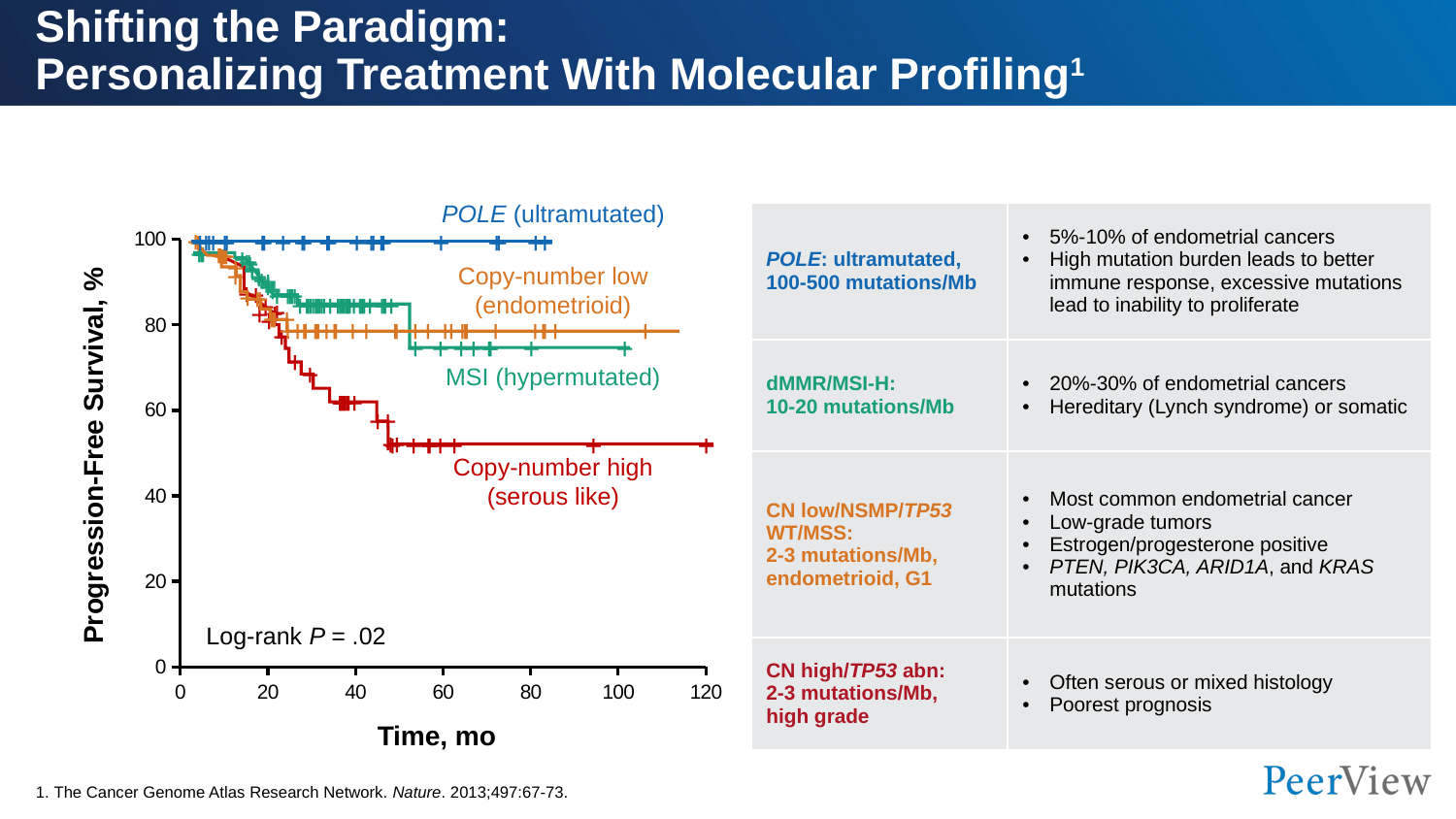
Is the progression-free survival for the Copy-number high (serous like) group at 100 months greater or less than 60%? less Does the Copy-number high (serous like) curve rise or fall as time increases? fall What is the label of the x axis of the chart? Time, mo Is the progression-free survival for the MSI (hypermutated) group at 100 months greater or less than 60%? greater Which group has the lowest progression-free survival at 100 months? Copy-number high (serous like) Is the progression-free survival for the POLE (ultramutated) group at 80 months greater or less than 80%? greater What log-rank P value is printed on the chart? P = .02 At 100 months, which group has higher progression-free survival: Copy-number low (endometrioid) or Copy-number high (serous like)? Copy-number low (endometrioid) How many survival curves (groups) are plotted on the chart? 4 What kind of chart is shown on the slide? line chart Which group has the highest progression-free survival at 80 months? POLE (ultramutated)